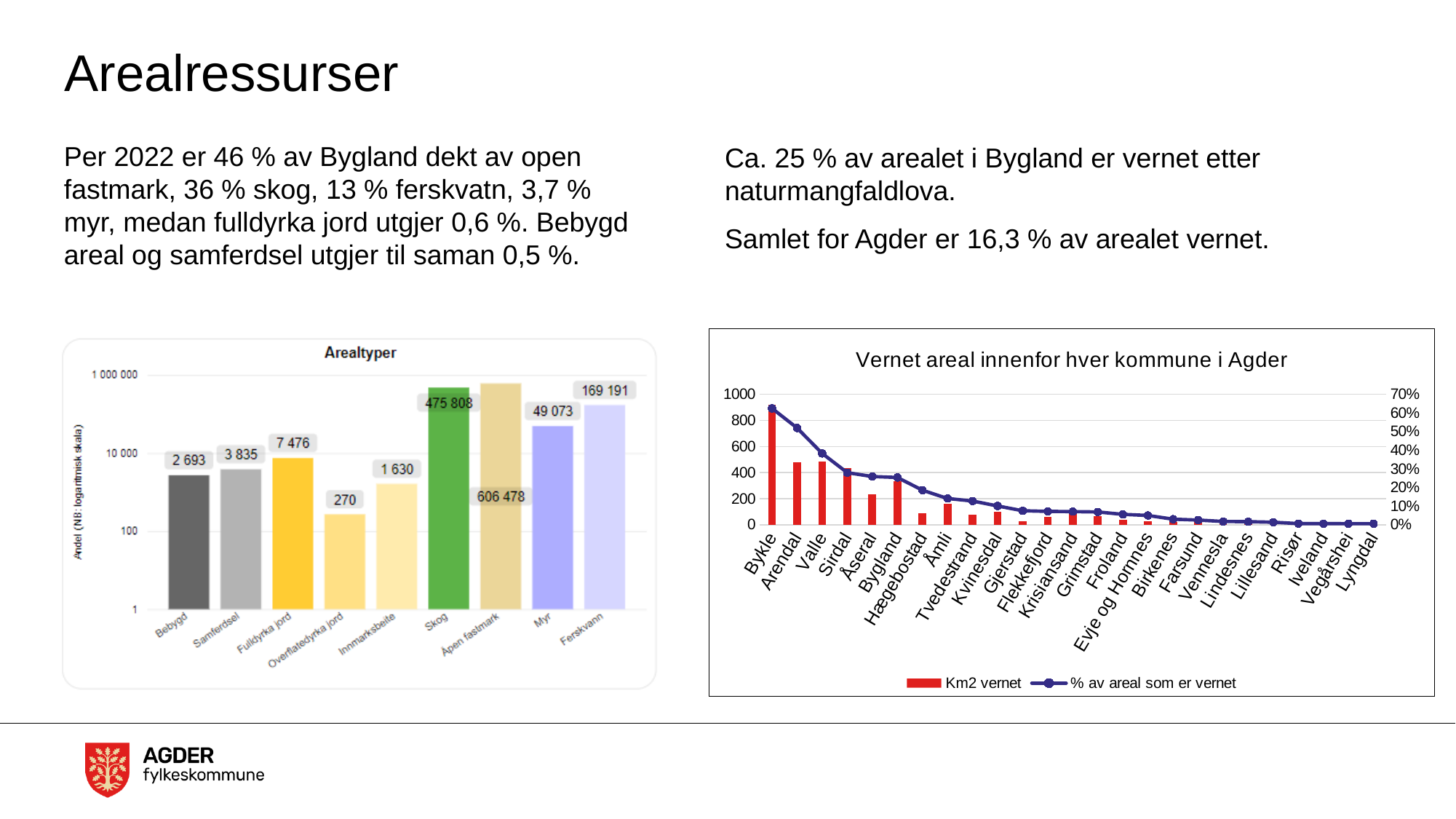
In the chart 'Vernet areal innenfor hver kommune i Agder', which municipality has the highest Km2 vernet? Bykle In the chart 'Vernet areal innenfor hver kommune i Agder', how many series does the legend list? 2 In the Arealtyper chart, which is larger, Myr or Fulldyrka jord? Myr In the Arealtyper chart, which category has the lowest value? Overflatedyrka jord In the Arealtyper chart, what is the value for Ferskvann? 169 191 In the chart 'Vernet areal innenfor hver kommune i Agder', does the '% av areal som er vernet' line rise or fall from left to right? fall In the Arealtyper chart, what is the difference between the values for Samferdsel and Bebygd? 1 142 In the chart 'Vernet areal innenfor hver kommune i Agder', is the Km2 vernet value for Bykle greater or less than 800? greater In the Arealtyper chart, what is the value for Overflatedyrka jord? 270 In the Arealtyper chart, what is the value for Skog? 475 808 How many categories are shown in the Arealtyper chart? 9 In the Arealtyper chart, which category has the highest value? Åpen fastmark